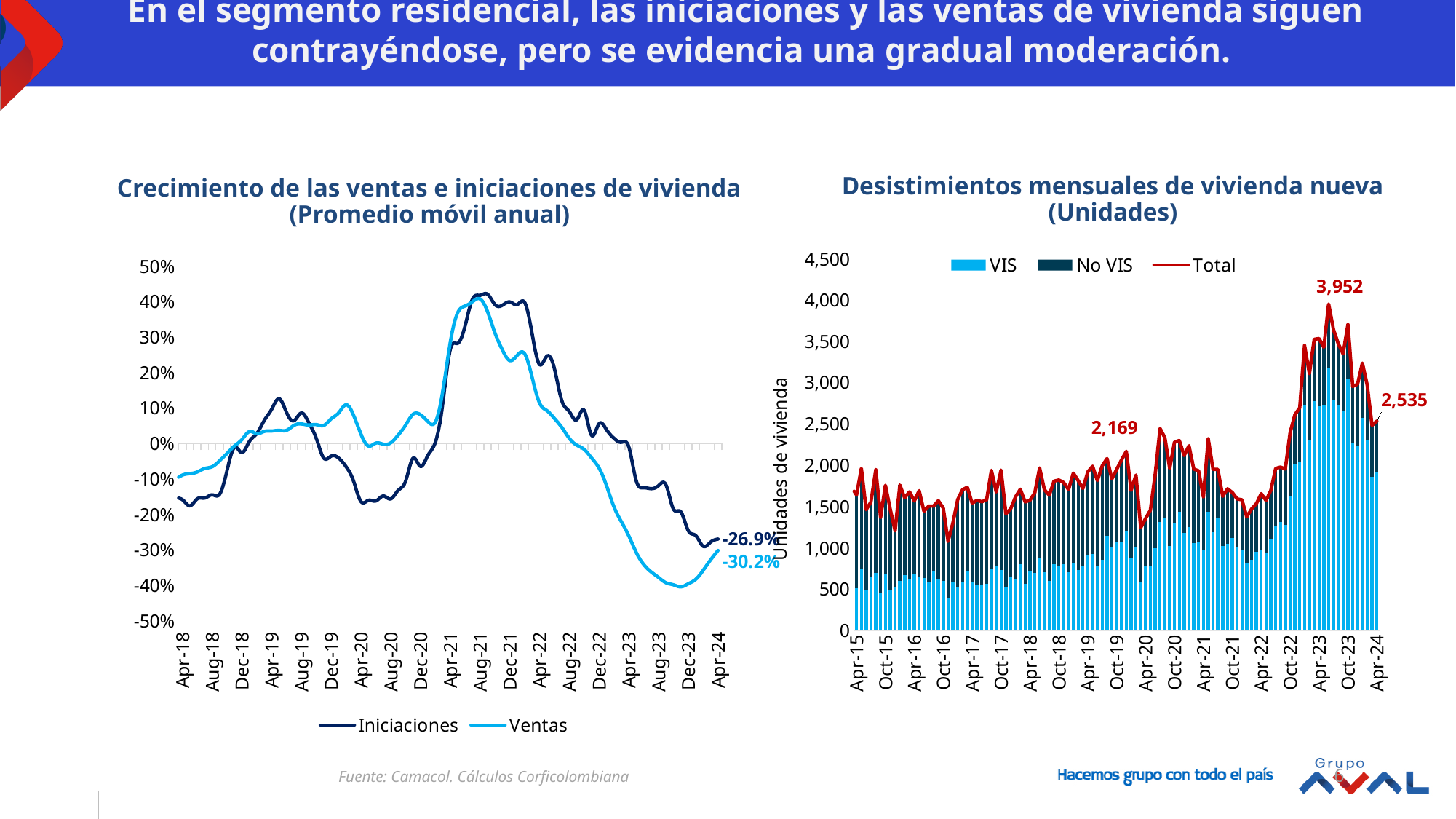
In the chart 'Desistimientos mensuales de vivienda nueva', how many entries does the legend list? 3 What kind of chart is 'Crecimiento de las ventas e iniciaciones de vivienda'? Line chart In the chart 'Crecimiento de las ventas e iniciaciones de vivienda', do the Ventas values rise or fall between Aug-21 and Dec-23? Fall In the chart 'Crecimiento de las ventas e iniciaciones de vivienda', what is the latest value shown for Ventas? -30.2% In the chart 'Crecimiento de las ventas e iniciaciones de vivienda', which series has the higher latest value, Iniciaciones or Ventas? Iniciaciones In the chart 'Desistimientos mensuales de vivienda nueva', what is the difference between the labelled peak of 3,952 and the Apr-24 value of 2,535? 1,417 In the chart 'Crecimiento de las ventas e iniciaciones de vivienda', how many series does the legend list? 2 In the chart 'Desistimientos mensuales de vivienda nueva', what is the peak Total value labelled on the chart? 3,952 In the chart 'Desistimientos mensuales de vivienda nueva', what is the Total value labelled at Apr-24? 2,535 In the chart 'Crecimiento de las ventas e iniciaciones de vivienda', is the Ventas value at Dec-23 greater or less than -30%? less In the chart 'Desistimientos mensuales de vivienda nueva', what is the Total value labelled near Oct-19? 2,169 In the chart 'Crecimiento de las ventas e iniciaciones de vivienda', what is the latest value shown for Iniciaciones? -26.9%